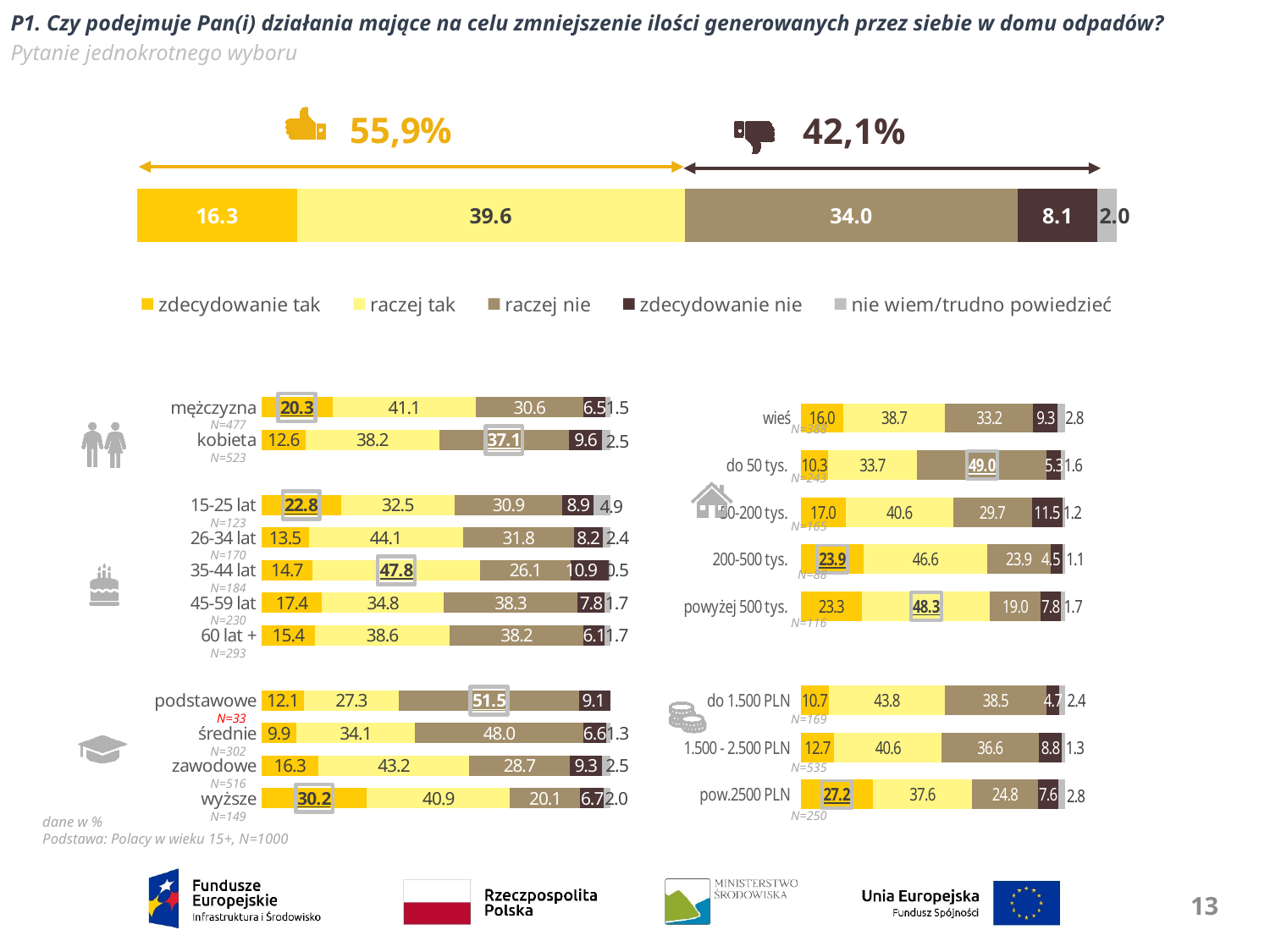
In the overall stacked bar at the top of the slide, what is the value for "raczej tak"? 39.6 How many series does the legend of the top stacked bar chart list? 5 What kind of chart is the top chart showing the overall answer distribution? Stacked bar chart In the education breakdown chart, which category has the highest "raczej nie" value? podstawowe In the income chart at the bottom right, which category has the lowest "zdecydowanie tak" value? do 1.500 PLN In the place-of-residence chart on the right, what is the "raczej nie" value for do 50 tys.? 49.0 In the education breakdown chart, which is larger: the "zdecydowanie tak" value for wyższe or for zawodowe? wyższe In the age breakdown chart, which age group has the highest "zdecydowanie tak" value? 15-25 lat In the top stacked bar, what is the total of the "zdecydowanie tak" and "raczej tak" segments? 55.9 In the income chart at the bottom right, how many income categories are shown? 3 In the age breakdown chart, what is the difference between the "raczej tak" values for 35-44 lat and 15-25 lat? 15.3 In the gender breakdown chart (mężczyzna / kobieta), what is the "raczej nie" value for kobieta? 37.1